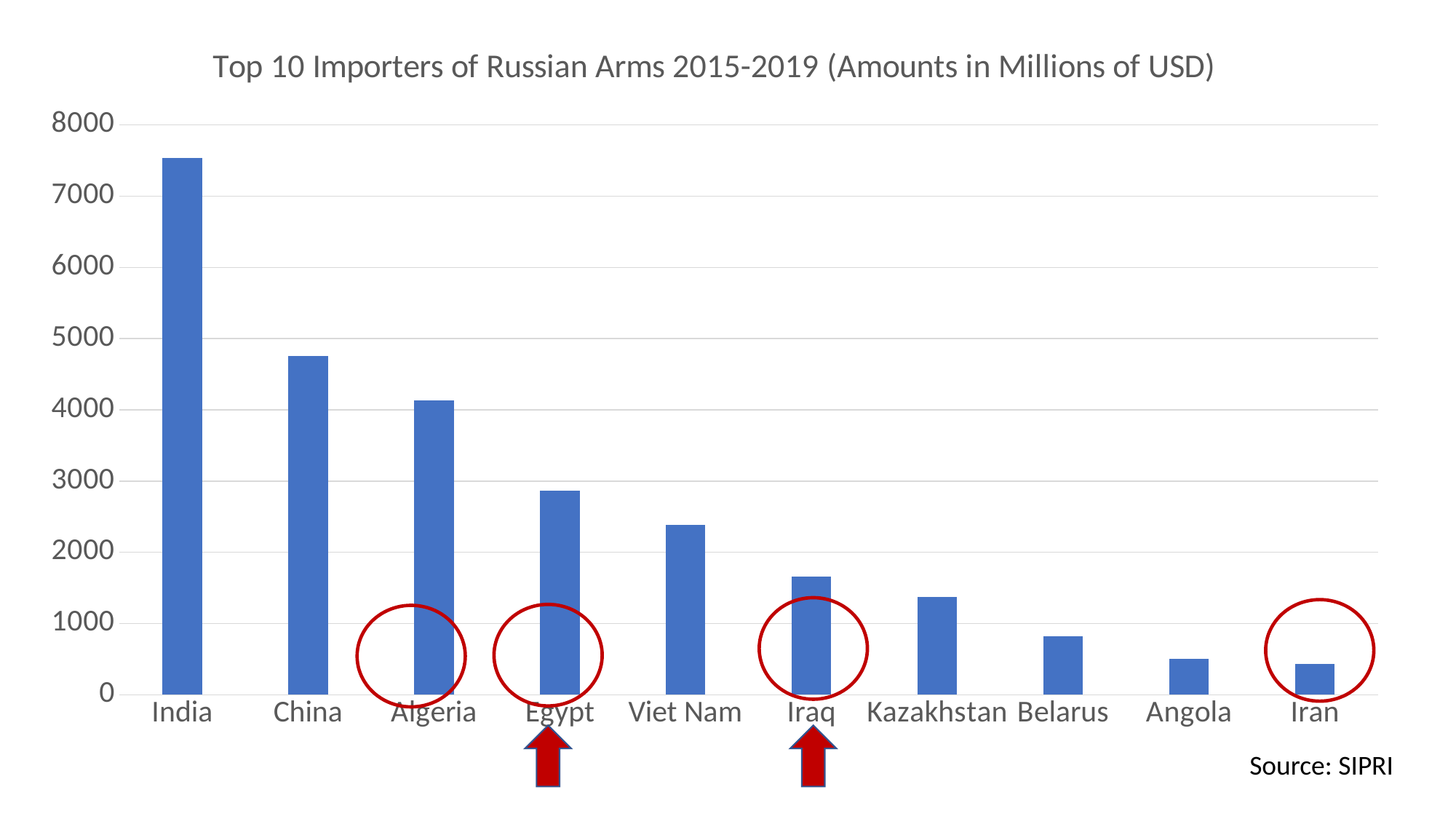
Is the value for Iraq greater or less than 1000? greater What is the title of the chart? Top 10 Importers of Russian Arms 2015-2019 (Amounts in Millions of USD) Which country has the lowest value in the chart? Iran Is the value for China greater or less than 5000? less Is the value for Algeria greater or less than 4000? greater Which country has the highest value in the chart? India Which has a larger value, Viet Nam or Kazakhstan? Viet Nam What type of chart is shown on the slide? bar chart Do the values rise or fall moving from left to right along the x axis? fall How many countries are shown in the chart? 10